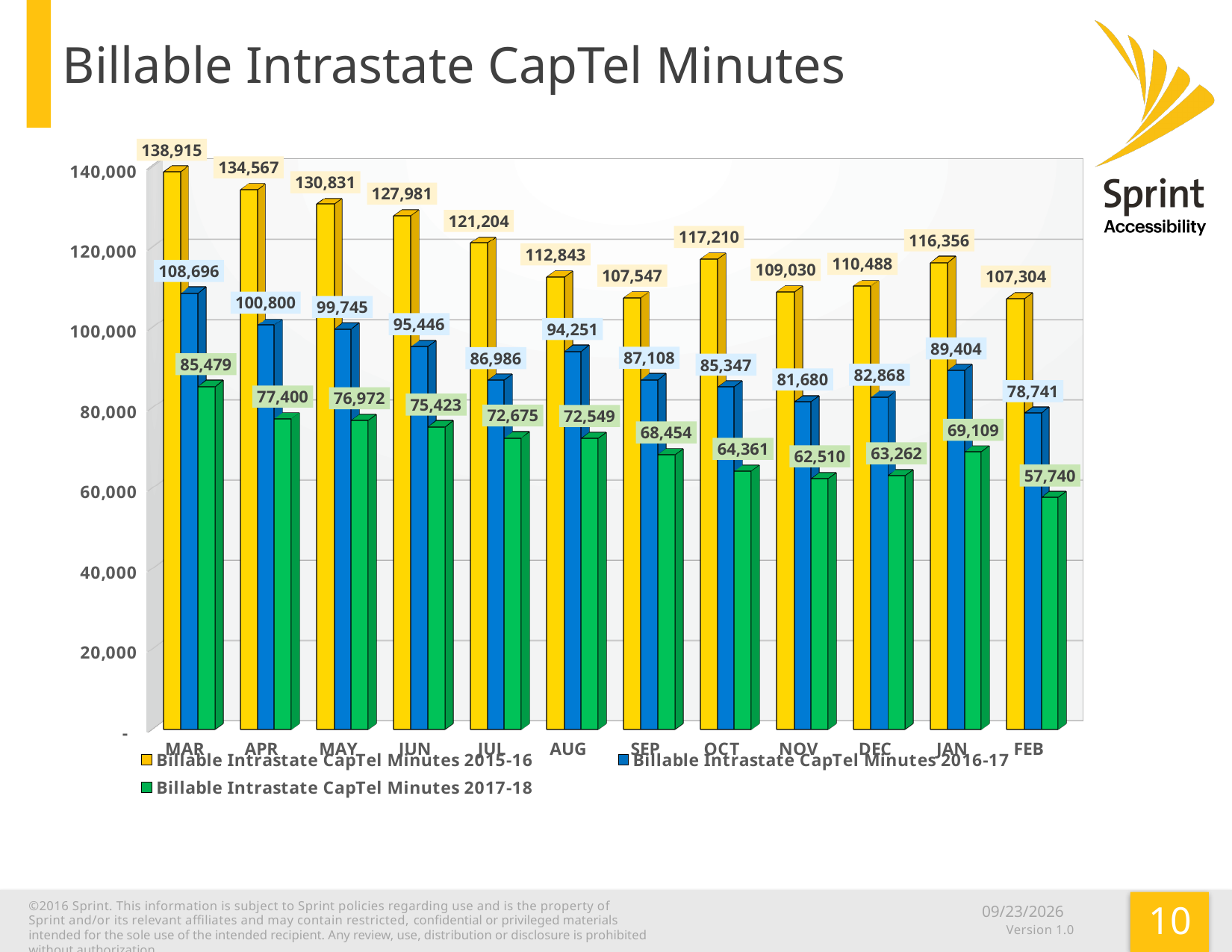
What is the value for FEB in the Billable Intrastate CapTel Minutes 2017-18 series? 57,740 How many months are shown on the x axis? 12 What is the difference between the 2015-16 and 2016-17 values for MAR? 30,219 What is the difference between the JAN and DEC values in the Billable Intrastate CapTel Minutes 2017-18 series? 5,847 What is the value for AUG in the Billable Intrastate CapTel Minutes 2016-17 series? 94,251 What is the value for MAR in the Billable Intrastate CapTel Minutes 2015-16 series? 138,915 What kind of chart is shown on the slide? Bar chart In the Billable Intrastate CapTel Minutes 2016-17 series, which is larger, JUL or AUG? AUG Do the values in the Billable Intrastate CapTel Minutes 2017-18 series generally rise or fall from MAR to FEB? Fall Which month has the highest value in the Billable Intrastate CapTel Minutes 2017-18 series? MAR How many series does the legend list? 3 Which month has the lowest value in the Billable Intrastate CapTel Minutes 2016-17 series? FEB